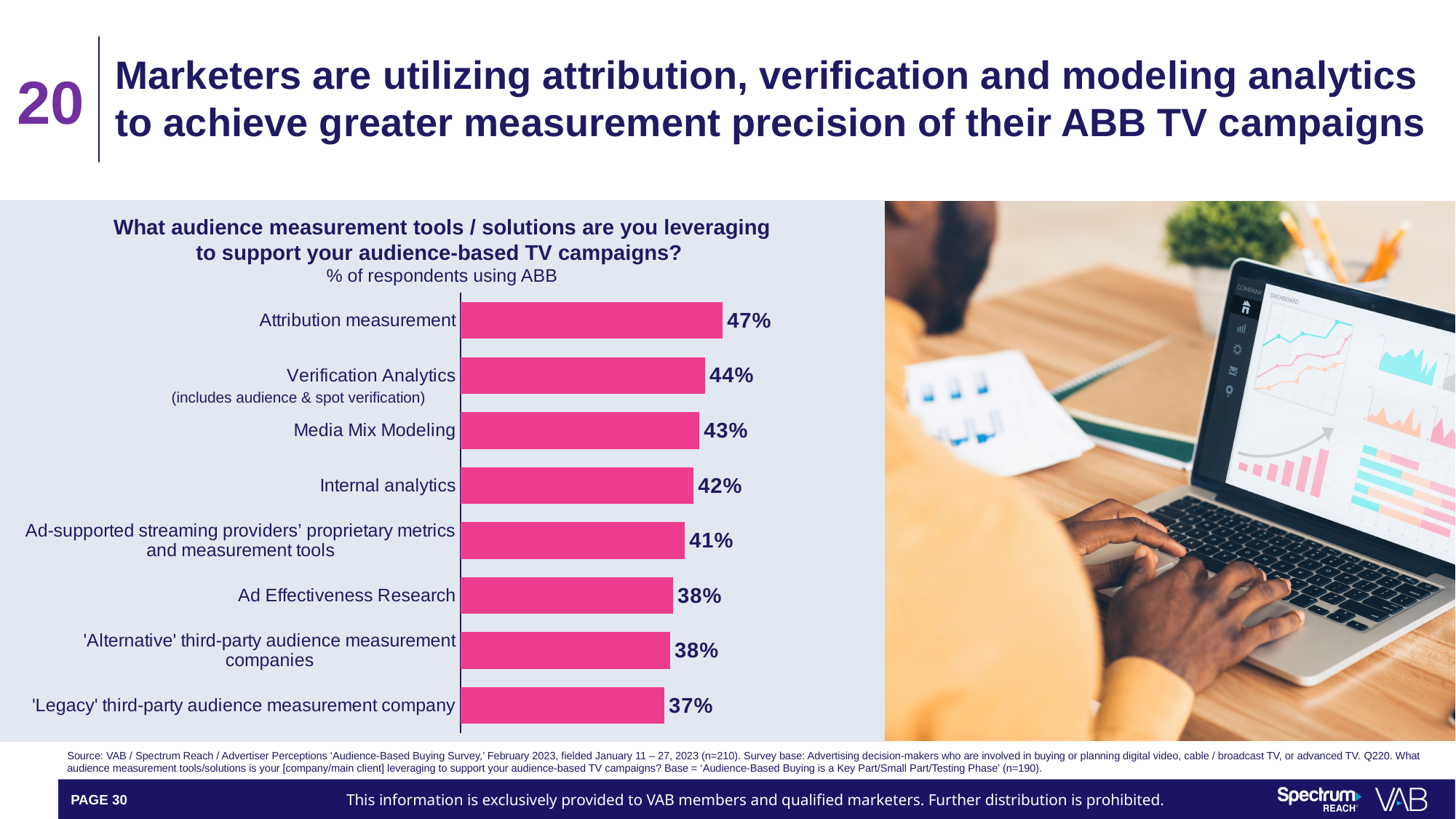
What is the value shown for Media Mix Modeling? 43% Which audience measurement tool has the highest percentage of respondents? Attribution measurement What type of chart is used to show the audience measurement tools data? Bar chart What is the difference in percentage points between Attribution measurement and Internal analytics? 5 What is the value for Ad-supported streaming providers' proprietary metrics and measurement tools? 41% How many audience measurement tools / solutions are listed in the chart? 8 Which has a higher value, Media Mix Modeling or Ad Effectiveness Research? Media Mix Modeling What percentage is shown for 'Legacy' third-party audience measurement company? 37% What is the difference between Verification Analytics and Ad Effectiveness Research? 6 What is the subtitle under the chart's question title describing the measure? % of respondents using ABB What percentage of respondents using ABB leverage Attribution measurement? 47% Which audience measurement tool has the lowest percentage of respondents? 'Legacy' third-party audience measurement company